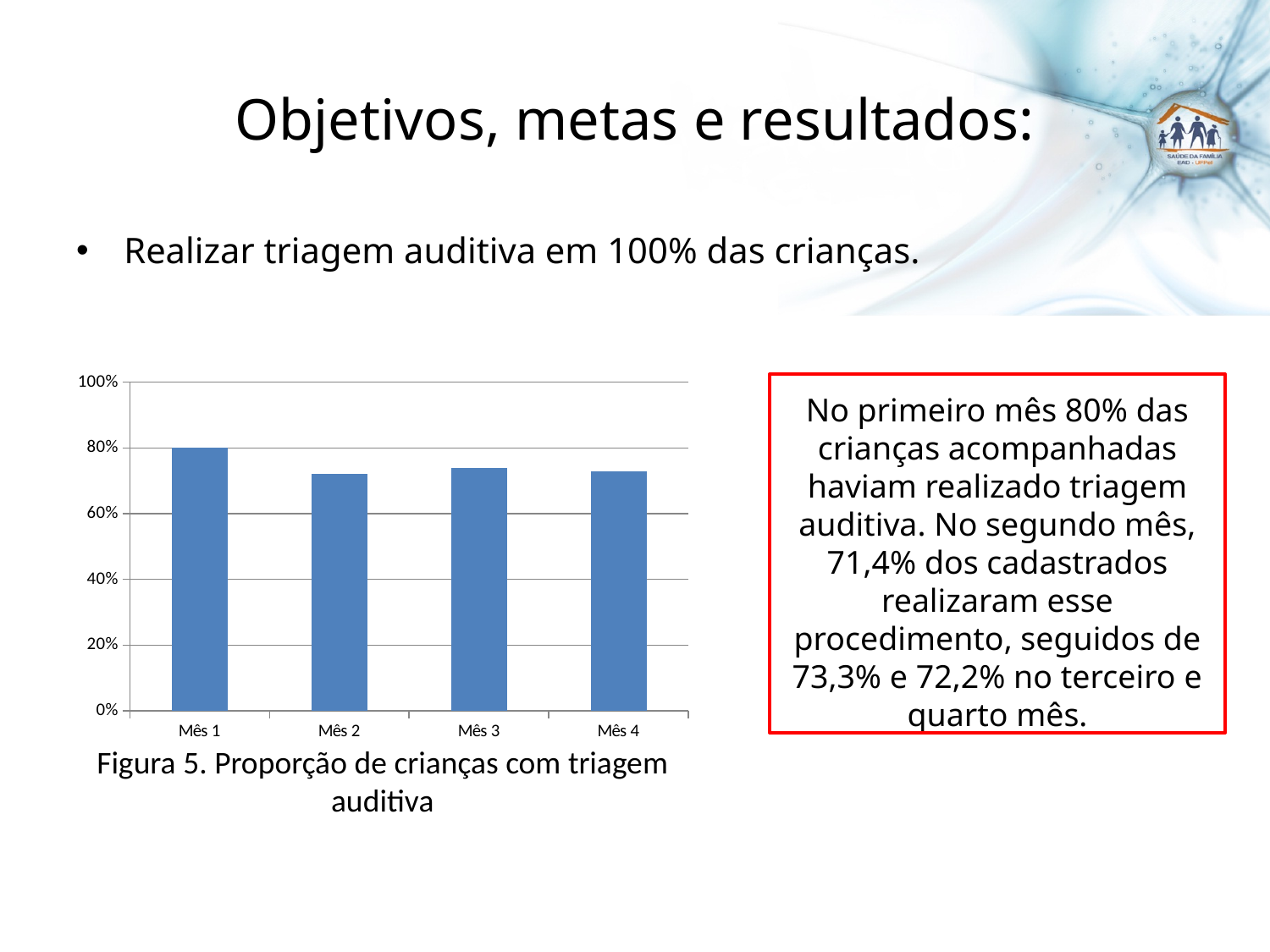
What kind of chart is shown? bar chart Is the value for Mês 4 greater or less than 80%? less Which is larger, the value for Mês 1 or the value for Mês 4? Mês 1 Which is larger, the value for Mês 1 or the value for Mês 3? Mês 1 Is the value for Mês 3 greater or less than 60%? greater What is the value for Mês 1? 80% Which month has the highest value? Mês 1 What is the caption of the chart? Figura 5. Proporção de crianças com triagem auditiva Is the value for Mês 2 greater or less than 60%? greater How many months are shown on the x axis? 4 Does the value rise or fall from Mês 1 to Mês 2? fall